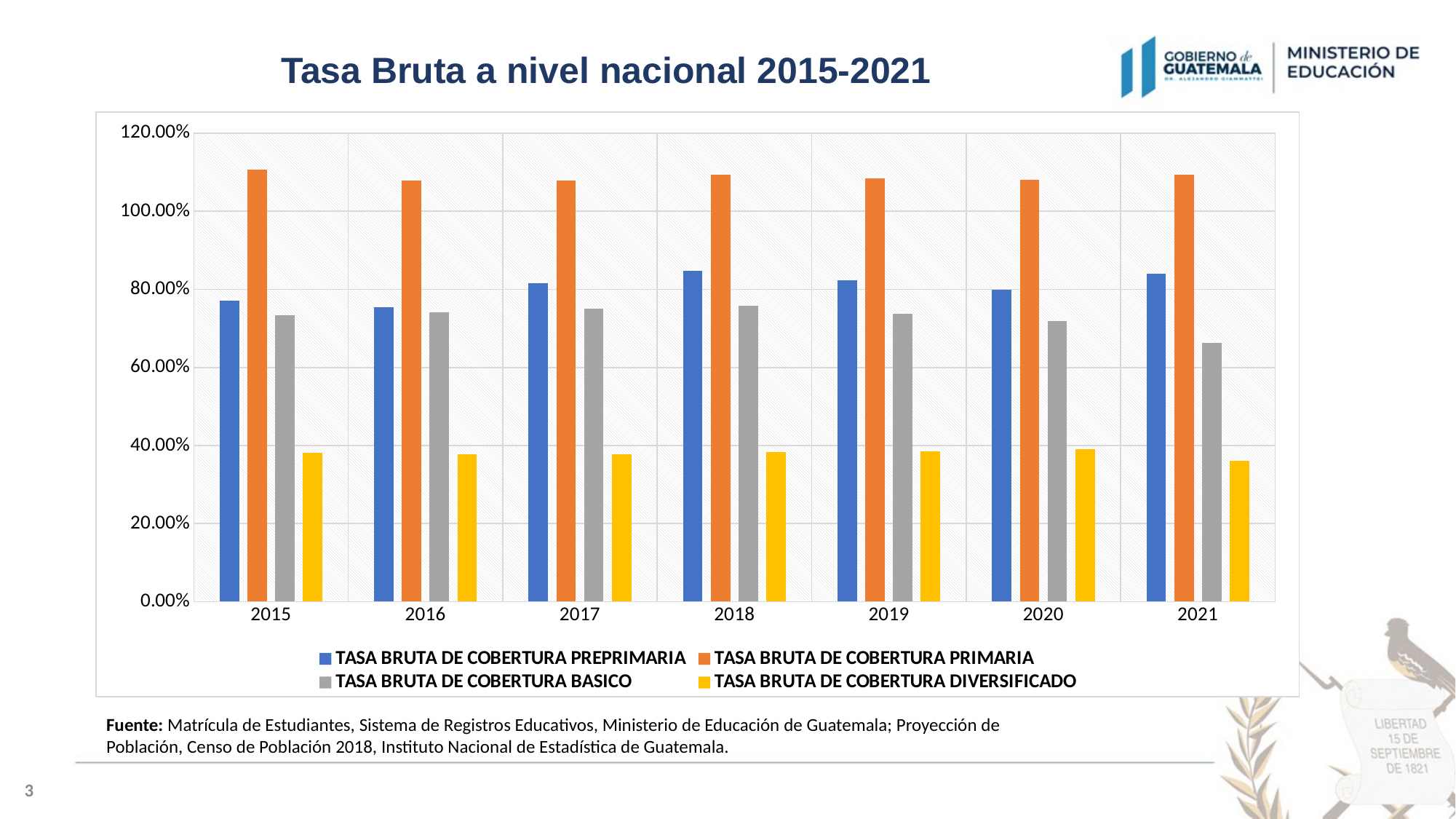
Is the value for TASA BRUTA DE COBERTURA DIVERSIFICADO in 2021 greater or less than 40.00%? less Which is larger: TASA BRUTA DE COBERTURA PREPRIMARIA in 2018 or in 2016? 2018 Which series has the lowest value in every year shown? TASA BRUTA DE COBERTURA DIVERSIFICADO Is the value for TASA BRUTA DE COBERTURA PRIMARIA in 2015 greater or less than 100.00%? greater What is the title of the chart? Tasa Bruta a nivel nacional 2015-2021 What kind of chart is shown on the slide? Bar chart In which year is TASA BRUTA DE COBERTURA BASICO lowest? 2021 How many series does the legend list? 4 How many years are shown on the x axis? 7 Is the value for TASA BRUTA DE COBERTURA PREPRIMARIA in 2018 greater or less than 80.00%? greater Which series has the highest value in every year shown? TASA BRUTA DE COBERTURA PRIMARIA